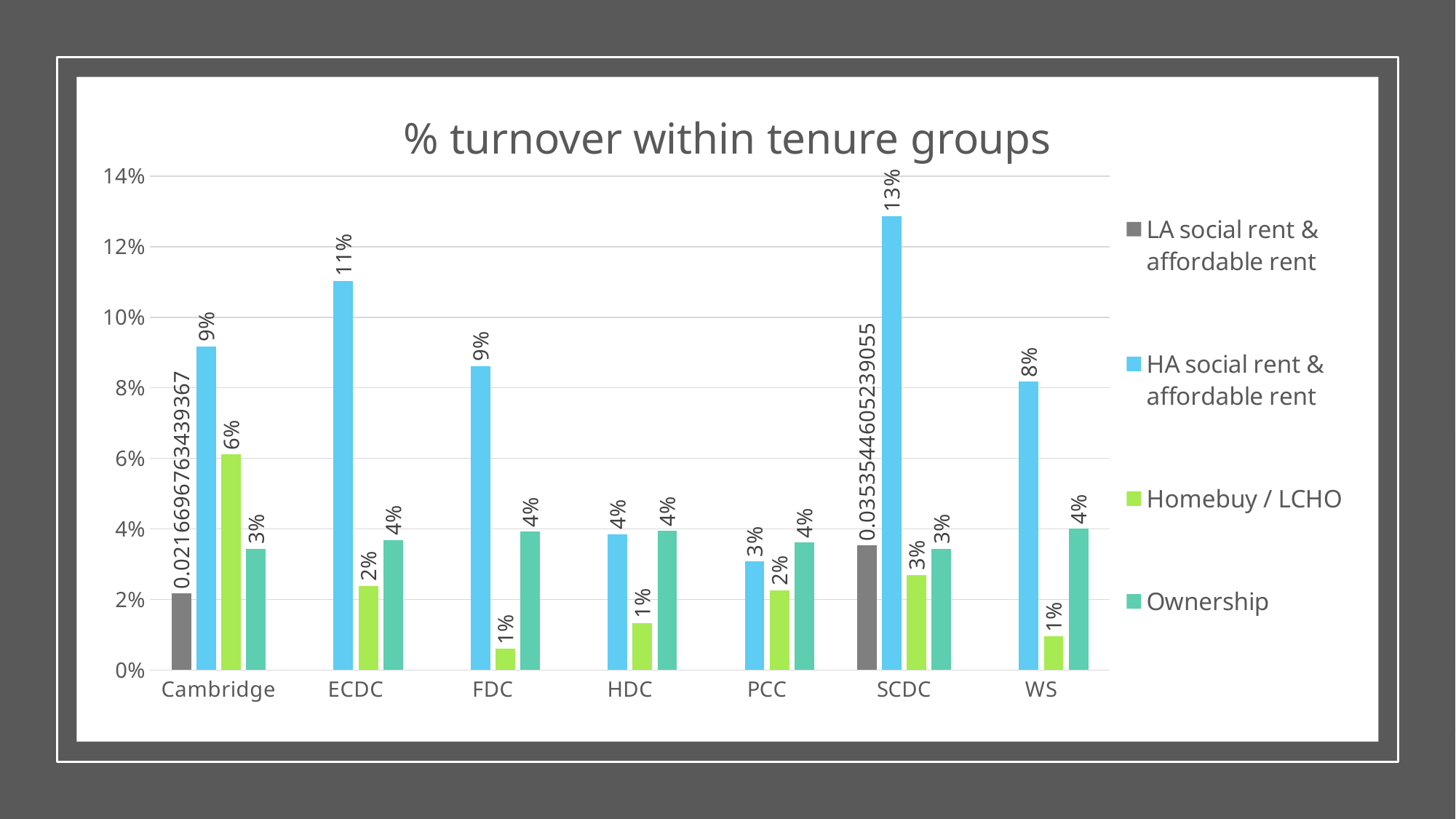
What is the value for HA social rent & affordable rent for SCDC? 13% Is the value for HA social rent & affordable rent for ECDC greater or less than 10%? greater What kind of chart is shown on the slide? Bar chart How many categories are shown on the x axis? 7 Which category has the highest value for HA social rent & affordable rent? SCDC What is the difference between the HA social rent & affordable rent values for SCDC and ECDC? 2% Which category has the lowest value for HA social rent & affordable rent? PCC What is the value for HA social rent & affordable rent for WS? 8% For Cambridge, which is larger: Homebuy / LCHO or Ownership? Homebuy / LCHO What is the value for Homebuy / LCHO for Cambridge? 6% How many series does the legend list? 4 What is the value for Ownership for ECDC? 4%